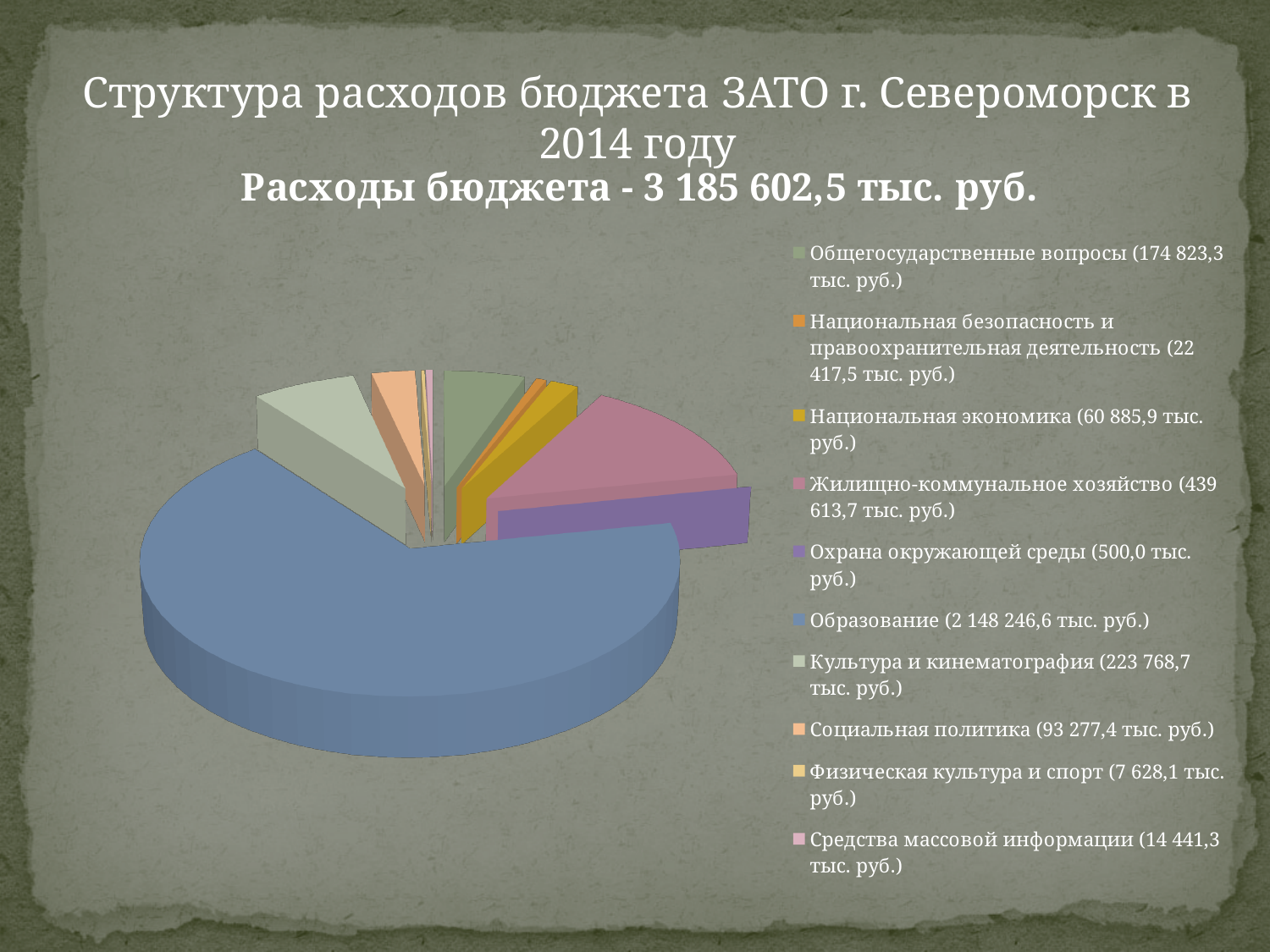
Which category has the largest share of the budget expenditures? Образование Which is larger: Жилищно-коммунальное хозяйство or Культура и кинематография? Жилищно-коммунальное хозяйство What kind of chart is shown on the slide? Pie chart What is the title of the slide containing the chart? Структура расходов бюджета ЗАТО г. Североморск в 2014 году How many categories does the legend of the pie chart list? 10 What is the value for Жилищно-коммунальное хозяйство? 439 613,7 тыс. руб. What total budget expenditure is stated on the slide? 3 185 602,5 тыс. руб. Which category has the smallest share of the budget expenditures? Охрана окружающей среды What is the value for Образование? 2 148 246,6 тыс. руб. What is the value for Социальная политика? 93 277,4 тыс. руб. What is the difference between Культура и кинематография and Общегосударственные вопросы? 48 945,4 тыс. руб. What is the value for Физическая культура и спорт? 7 628,1 тыс. руб.